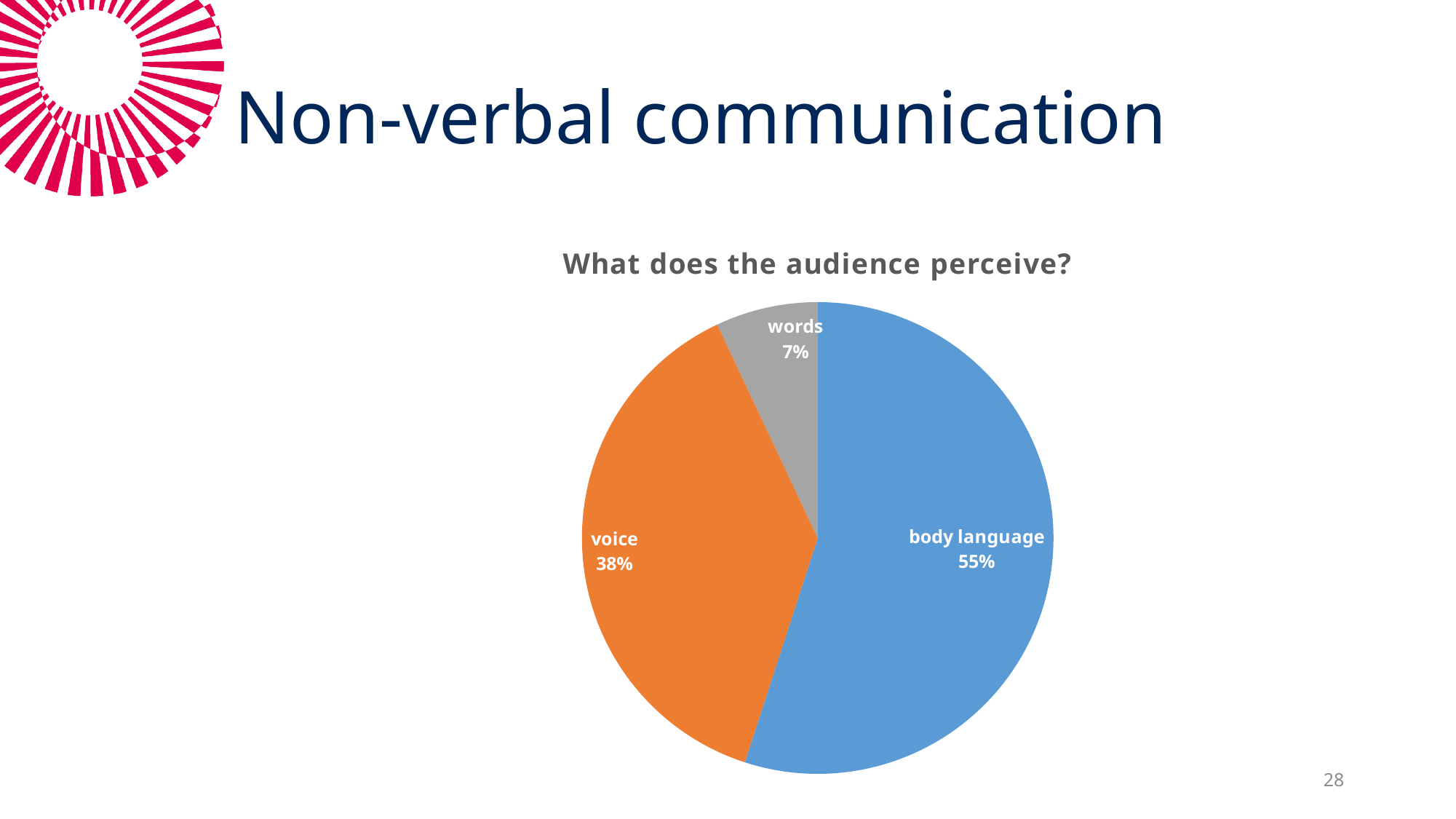
What is the title of the chart? What does the audience perceive? What kind of chart is shown on the slide? pie chart What colour is the slice for voice? orange What share of the pie does body language account for? 55% Which category has the smallest slice of the pie? words What is the value shown for voice? 38% What is the value shown for words? 7% What is the difference in percentage points between body language and voice? 17 Which category has the largest slice of the pie? body language What is the difference in percentage points between voice and words? 31 Which is larger, the share for voice or the share for words? voice How many slices does the pie chart have? 3